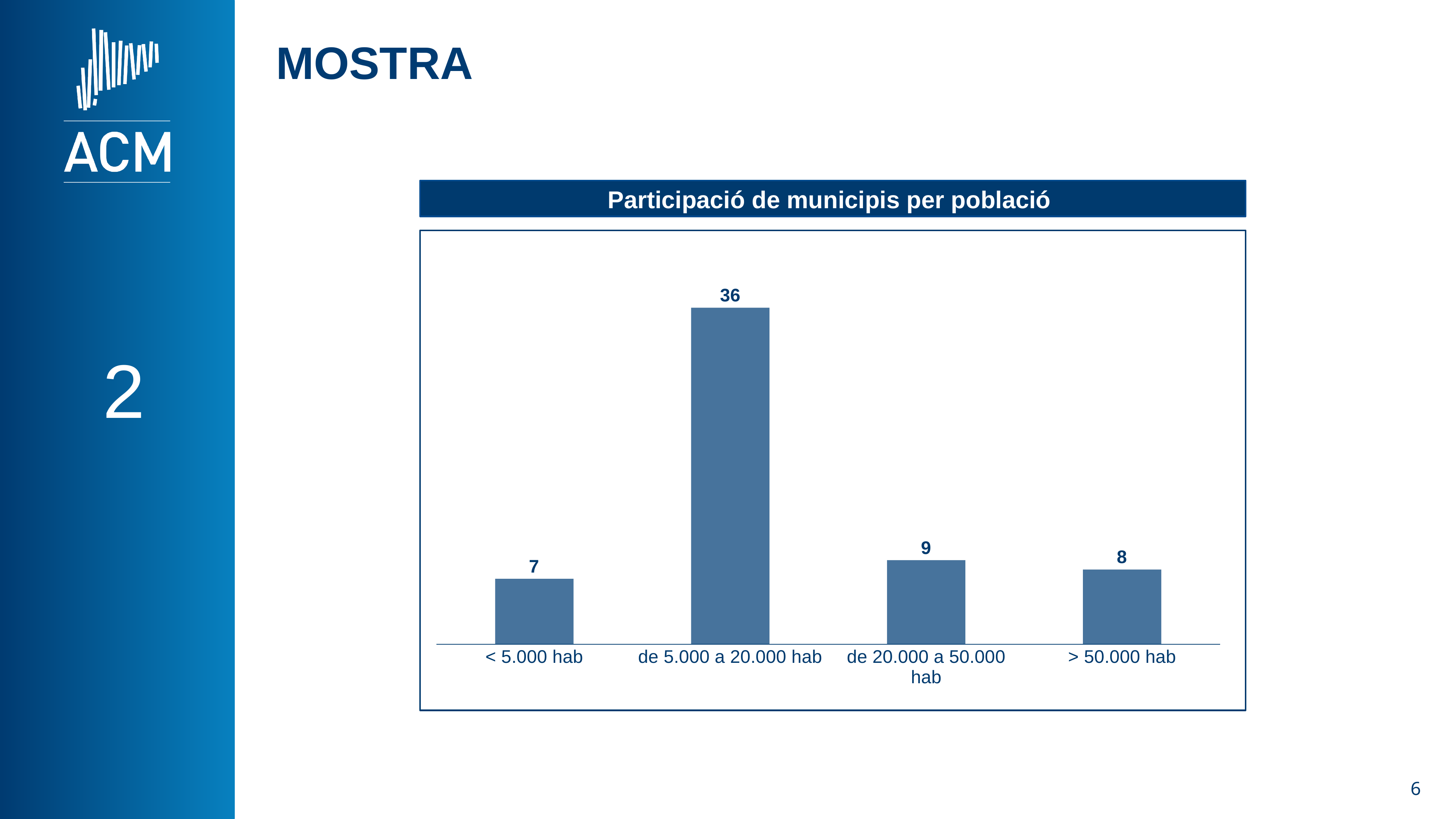
Which category has the lowest value? < 5.000 hab What kind of chart is shown on the slide? bar chart What is the value for '> 50.000 hab'? 8 What is the value for 'de 5.000 a 20.000 hab'? 36 What is the difference between the values for 'de 5.000 a 20.000 hab' and 'de 20.000 a 50.000 hab'? 27 Which category has the highest value? de 5.000 a 20.000 hab What is the value for 'de 20.000 a 50.000 hab'? 9 What is the title of the chart? Participació de municipis per població How many categories are shown on the x axis? 4 Which is larger, the value for 'de 20.000 a 50.000 hab' or the value for '> 50.000 hab'? de 20.000 a 50.000 hab What is the value for '< 5.000 hab'? 7 What is the difference between the values for '> 50.000 hab' and '< 5.000 hab'? 1